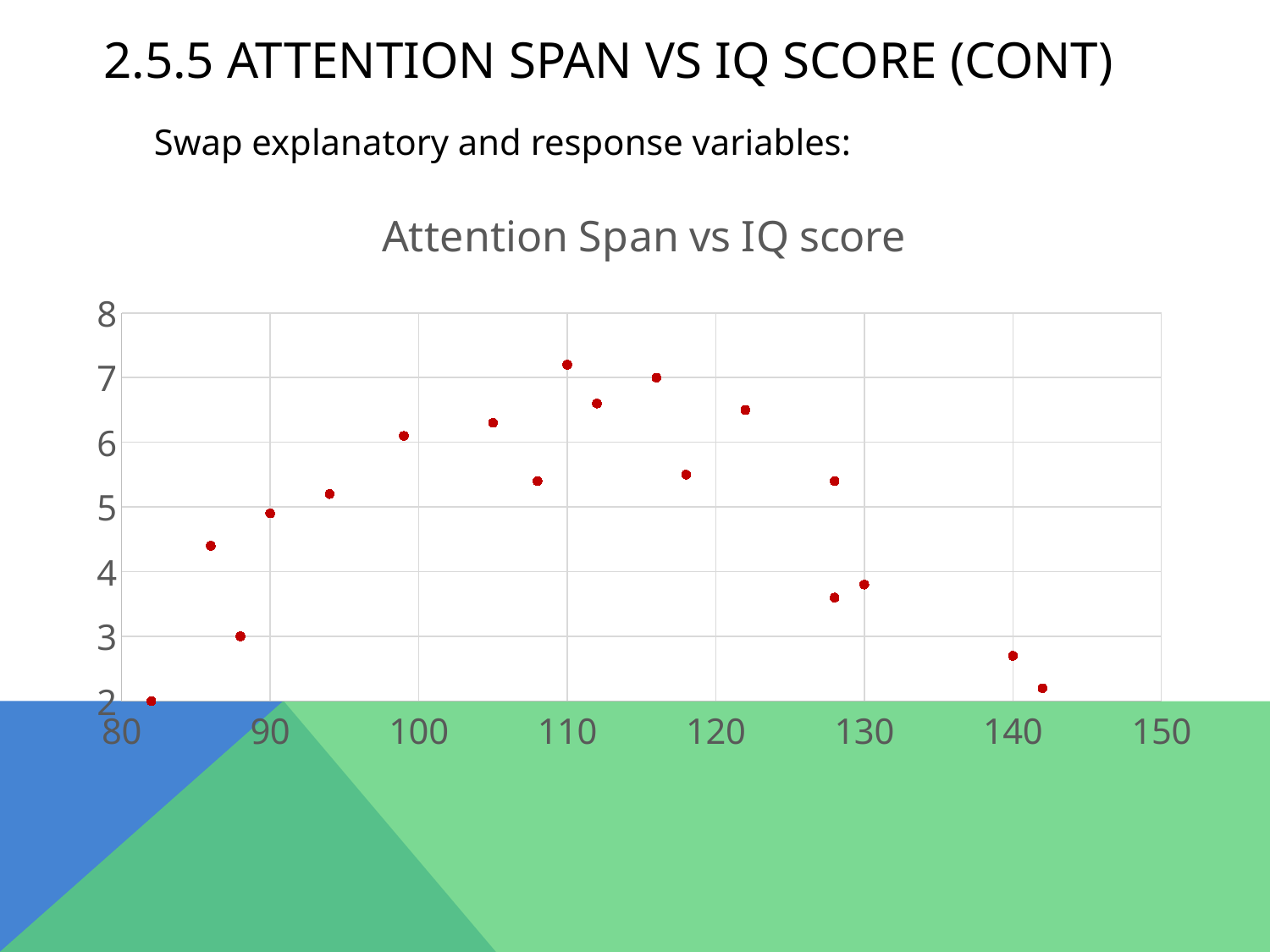
Is the value plotted at an IQ score of 108 greater or less than 5? greater Do the plotted values generally rise or fall as the IQ score increases from 120 to 150? fall Is the value plotted at an IQ score of 140 greater or less than 3? less Is the value plotted at an IQ score of 86 greater or less than 4? greater How many data points are plotted on the chart? 18 What kind of chart is shown on the slide? scatter chart What is the title of the chart? Attention Span vs IQ score Which has the larger plotted value: the point at IQ score 86 or the point at IQ score 88? 86 Which has the larger plotted value: the point at IQ score 110 or the point at IQ score 140? 110 What is the highest value shown on the vertical axis? 8